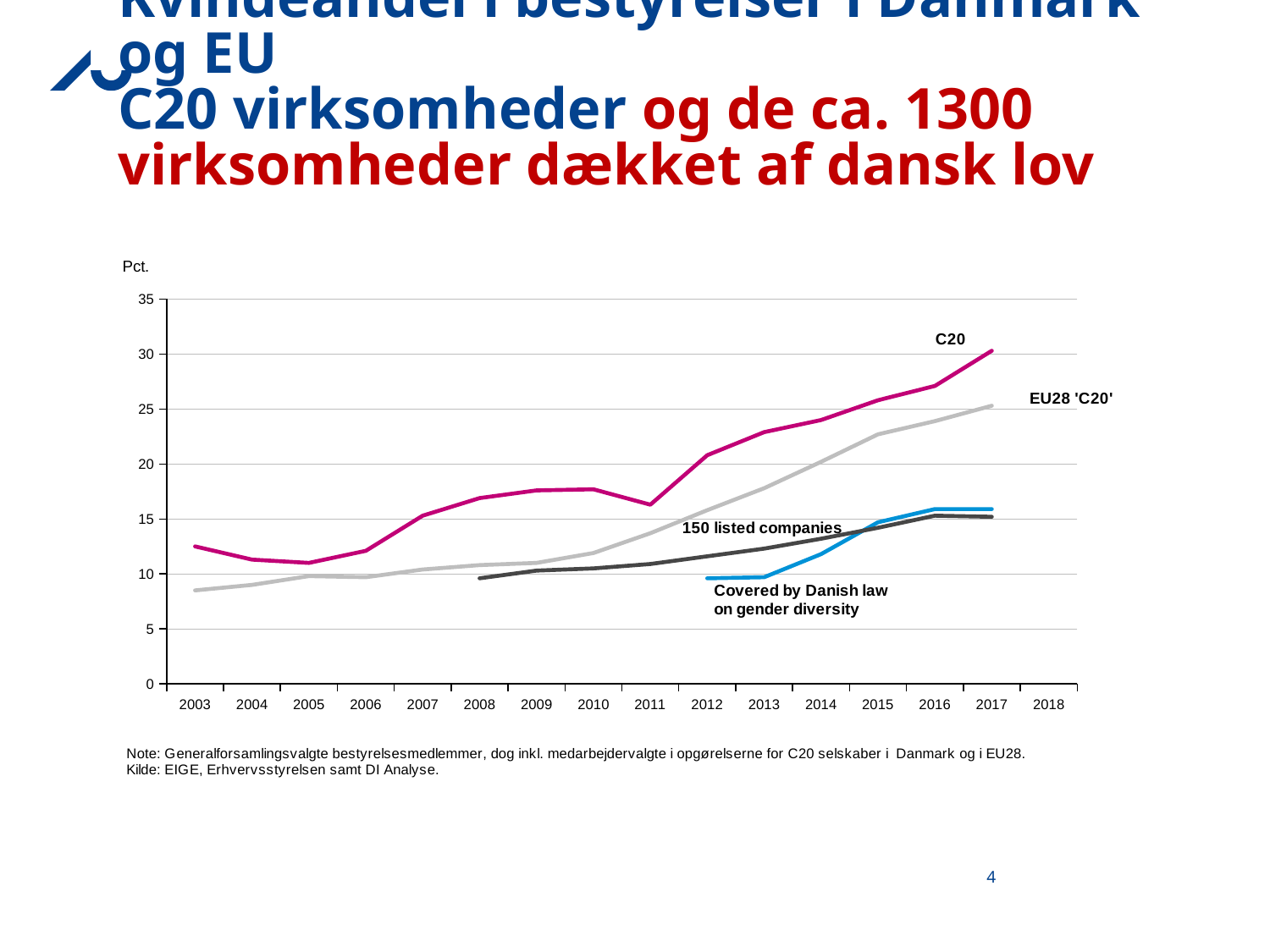
Which series has the highest value in 2017? C20 How many data series are plotted in the chart? 4 What unit is shown on the vertical axis of the chart? Pct. What kind of chart is shown on the slide? line chart Is the value for C20 in 2011 greater or less than 15? greater Does the EU28 'C20' series generally rise or fall from 2003 to 2017? rise Which is larger in 2010, the value for C20 or the value for EU28 'C20'? C20 Is the value for EU28 'C20' in 2003 greater or less than 10? less Which series has the lowest value in 2017? 150 listed companies